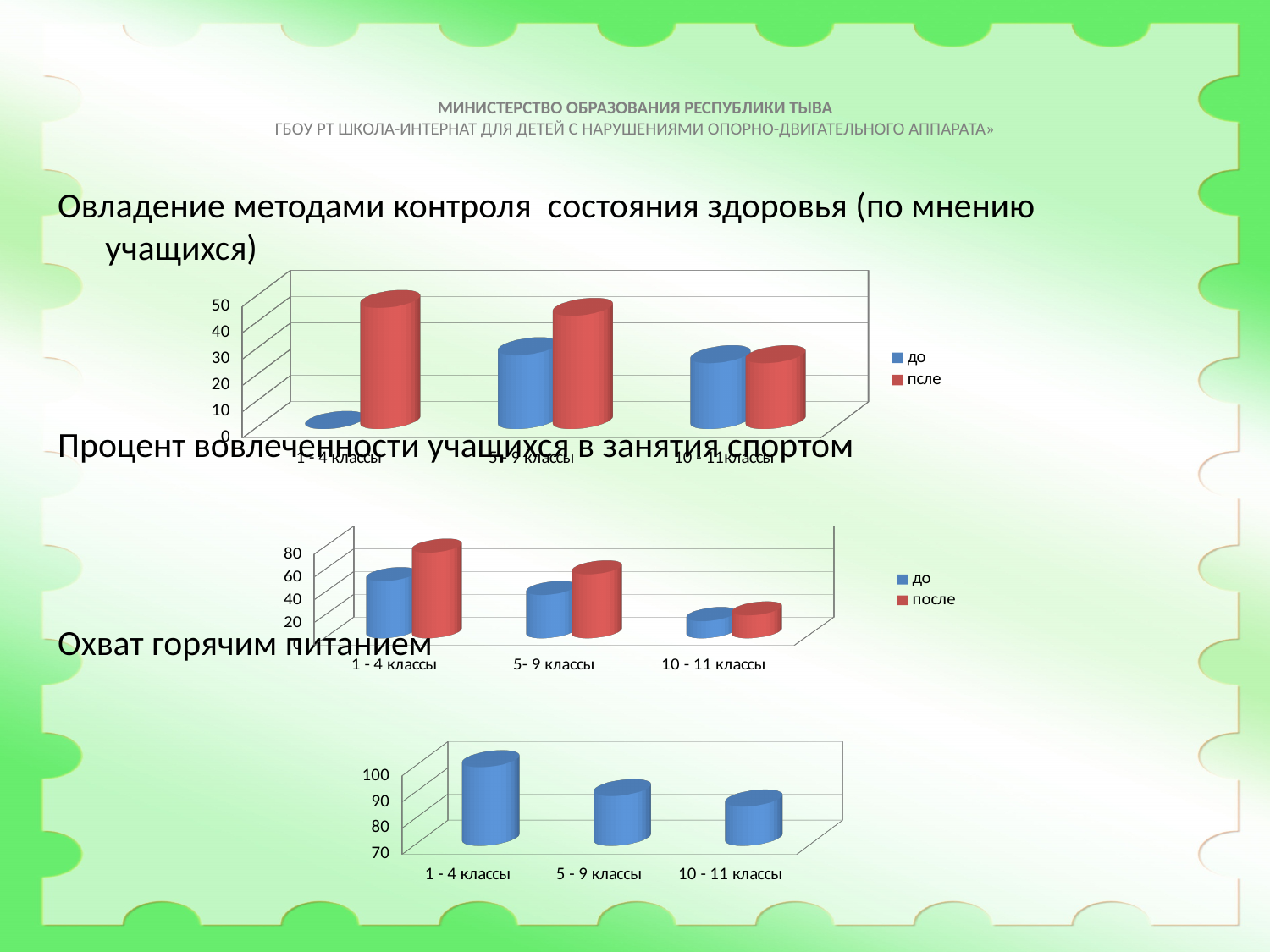
In the 'Процент вовлеченности учащихся в занятия спортом' chart, is the 'после' value for 1 - 4 классы greater or less than 60? greater How many categories does the 'Охват горячим питанием' chart show? 3 In the 'Овладение методами контроля состояния здоровья' chart, for 5 - 9 классы, which is larger: 'до' or 'после'? после In the 'Овладение методами контроля состояния здоровья' chart, is the 'после' value for 1 - 4 классы greater or less than 40? greater What are the two legend entries in the 'Процент вовлеченности учащихся в занятия спортом' chart? до, после In the 'Процент вовлеченности учащихся в занятия спортом' chart, which category has the lowest 'до' value? 10 - 11 классы In the 'Овладение методами контроля состояния здоровья' chart, which category has the lowest 'до' value? 1 - 4 классы In the 'Охват горячим питанием' chart, do the values rise or fall from 1 - 4 классы to 10 - 11 классы? fall How many series does the legend of the 'Овладение методами контроля состояния здоровья' chart list? 2 In the 'Овладение методами контроля состояния здоровья' chart, which category has the highest 'после' value? 1 - 4 классы In the 'Охват горячим питанием' chart, which category has the highest value? 1 - 4 классы What kind of chart is the 'Охват горячим питанием' chart? bar chart